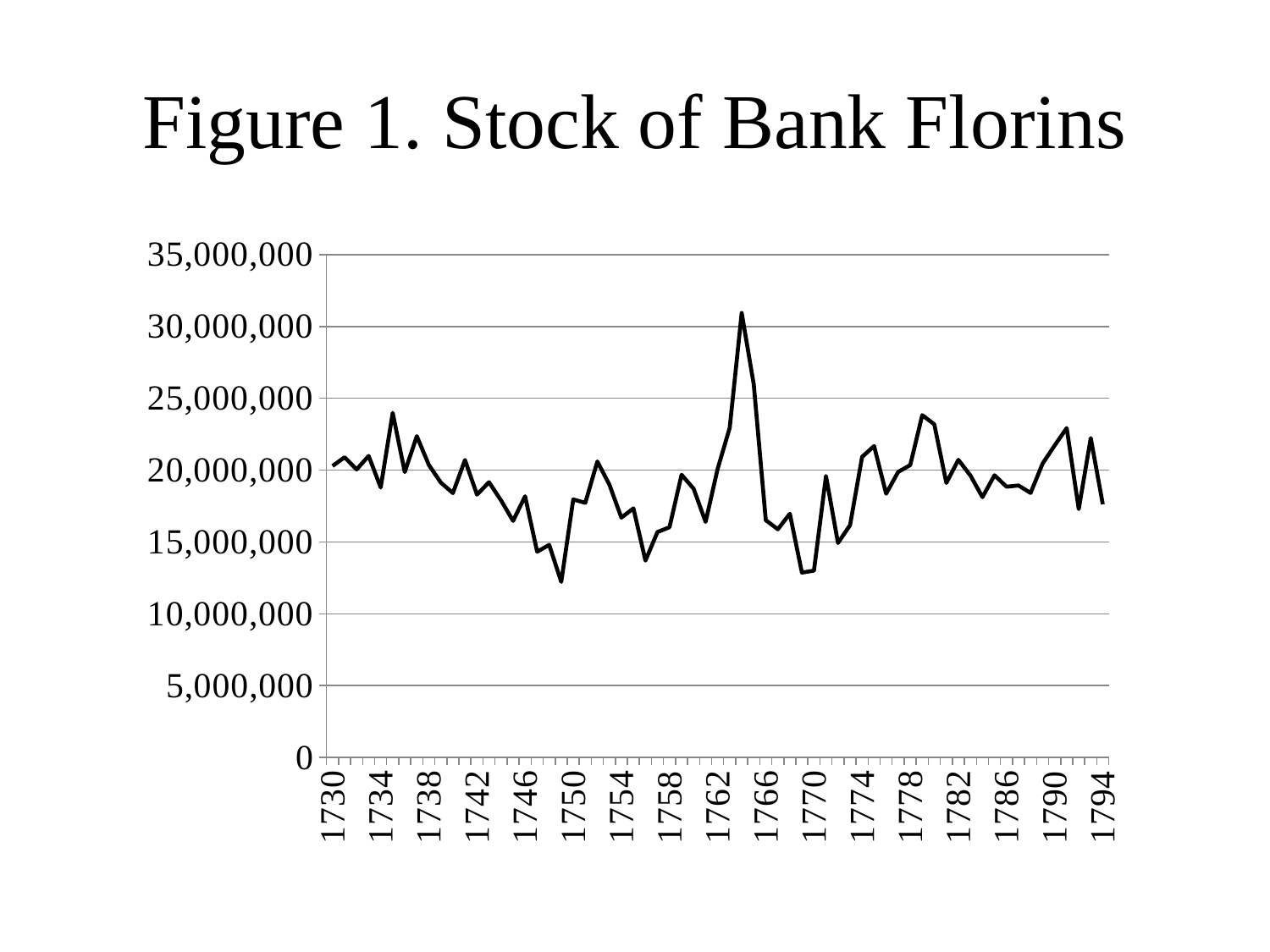
What is the highest value shown on the y axis? 35,000,000 Is the value for 1794 greater or less than 20,000,000? less What kind of chart is shown on the slide? line chart Which year has the larger value, 1764 or 1770? 1764 Does the line rise or fall between 1764 and 1770? fall Is the value for 1770 greater or less than 15,000,000? less What is the last year labelled on the x axis? 1794 What is the title of the chart? Figure 1. Stock of Bank Florins Is the value for 1735 greater or less than 20,000,000? greater In which year does the line reach its highest point? 1764 What is the first year labelled on the x axis? 1730